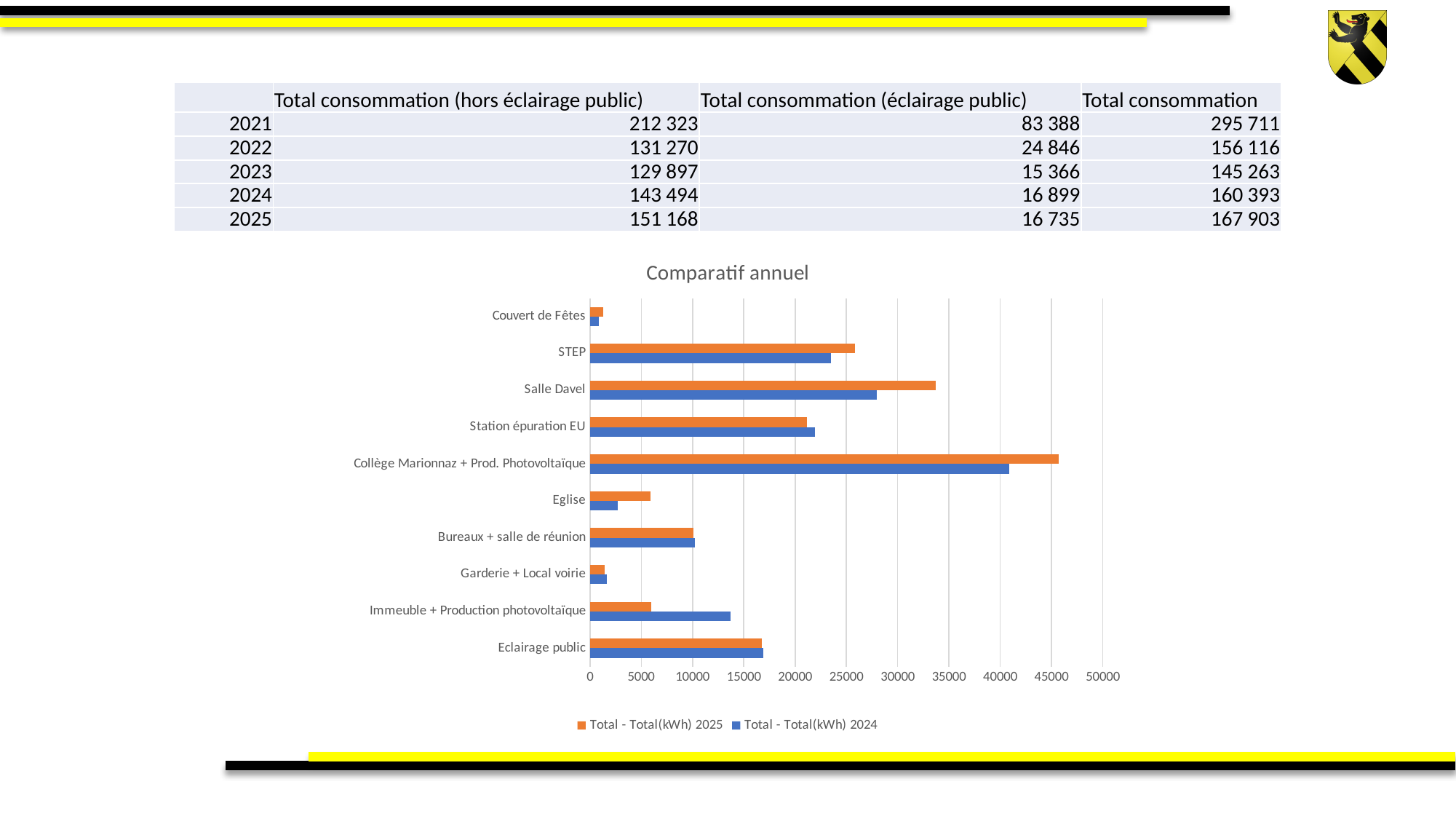
In the "Comparatif annuel" chart, which colour represents the Total - Total(kWh) 2024 series? blue How many categories are shown on the y axis of the "Comparatif annuel" chart? 10 In the "Comparatif annuel" chart, for Eglise, which series has the larger value: Total - Total(kWh) 2025 or Total - Total(kWh) 2024? Total - Total(kWh) 2025 In the "Comparatif annuel" chart, is the Total - Total(kWh) 2025 value for Salle Davel greater or less than 30000? greater What kind of chart is "Comparatif annuel"? bar chart In the "Comparatif annuel" chart, for Immeuble + Production photovoltaïque, which series has the larger value: Total - Total(kWh) 2025 or Total - Total(kWh) 2024? Total - Total(kWh) 2024 In the "Comparatif annuel" chart, is the Total - Total(kWh) 2025 value for Collège Marionnaz + Prod. Photovoltaïque greater or less than 40000? greater How many series does the legend of the "Comparatif annuel" chart list? 2 In the "Comparatif annuel" chart, is the Total - Total(kWh) 2024 value for Eglise greater or less than 5000? less In the "Comparatif annuel" chart, which category has the highest value for Total - Total(kWh) 2025? Collège Marionnaz + Prod. Photovoltaïque In the "Comparatif annuel" chart, which category has the lowest value for Total - Total(kWh) 2024? Couvert de Fêtes